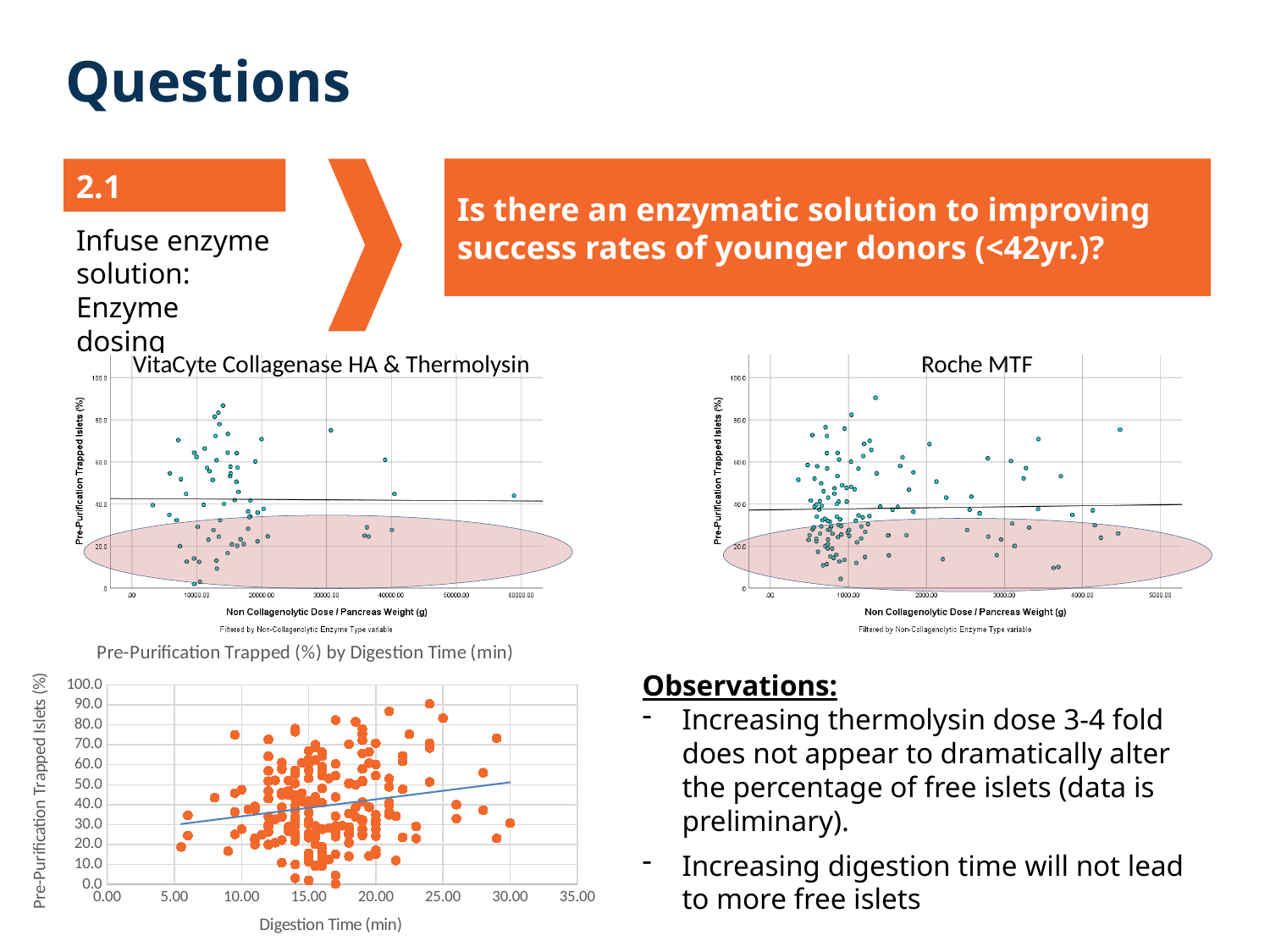
What kind of chart is the 'Roche MTF' chart? Scatter plot What is the maximum value shown on the x axis of the 'Pre-Purification Trapped (%) by Digestion Time (min)' chart? 35.00 What is the title of the scatter plot at the top left of the slide? VitaCyte Collagenase HA & Thermolysin In the 'Pre-Purification Trapped (%) by Digestion Time (min)' chart, is the highest plotted point greater or less than 80? greater In the 'Pre-Purification Trapped (%) by Digestion Time (min)' chart, is the lowest plotted point greater or less than 10? less What is the x-axis title of the 'Roche MTF' chart? Non Collagenolytic Dose / Pancreas Weight (g) In the 'Pre-Purification Trapped (%) by Digestion Time (min)' chart, does the fitted trend line rise or fall as digestion time increases? Rises What kind of chart is the 'Pre-Purification Trapped (%) by Digestion Time (min)' chart at the bottom left of the slide? Scatter plot